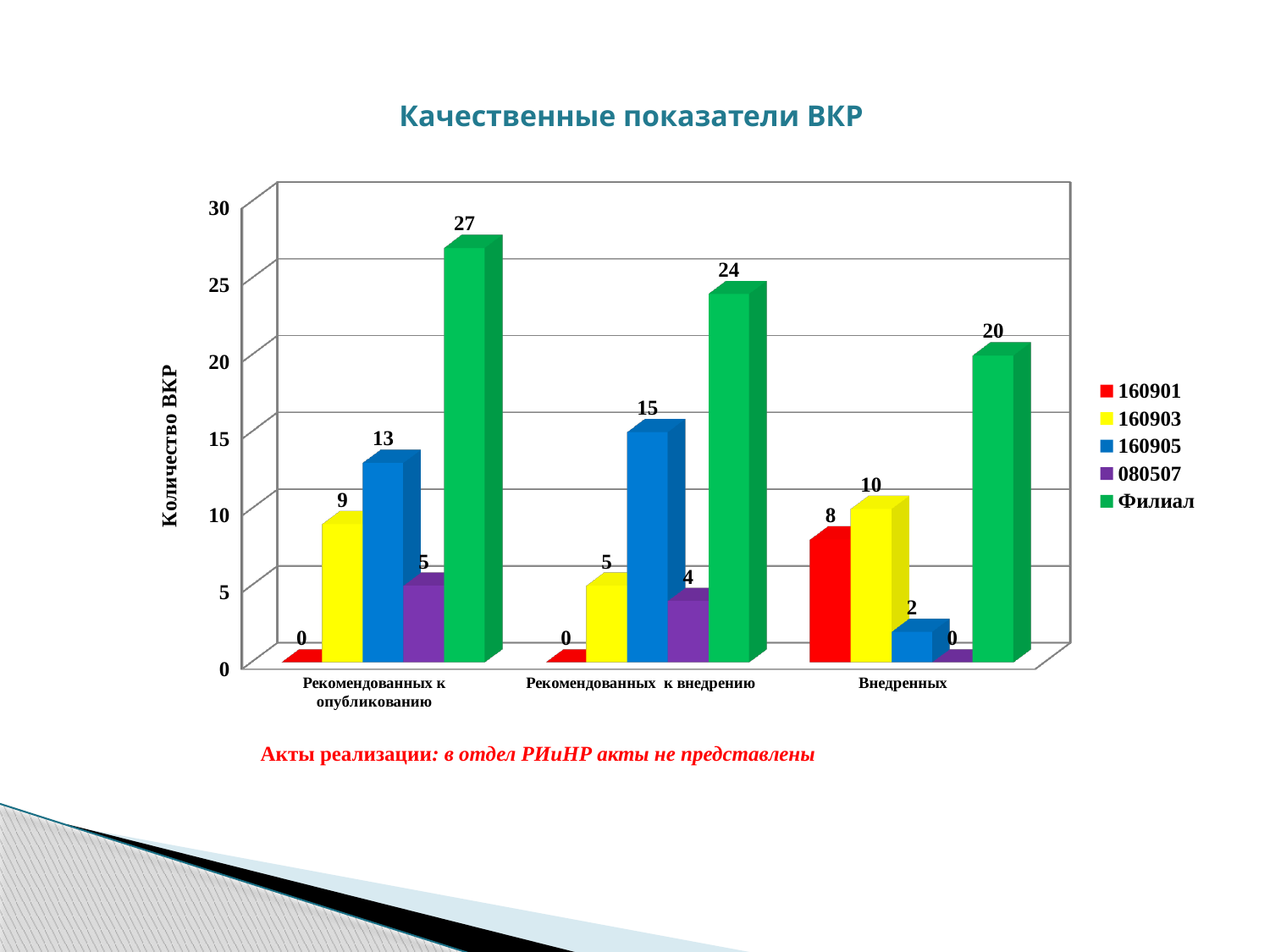
Which is larger in the Внедренных category: 160903 or 160905? 160903 What is the title of the y axis? Количество ВКР How many categories are shown on the x axis? 3 Which series has the lowest value in the Рекомендованных к опубликованию category? 160901 What is the value for Филиал in the Рекомендованных к опубликованию category? 27 How many series does the legend list? 5 What is the value for 080507 in the Рекомендованных к внедрению category? 4 What kind of chart is shown on the slide? Bar chart What is the value for 160901 in the Внедренных category? 8 Which series has the highest value in the Внедренных category? Филиал What is the difference between the Филиал values for Рекомендованных к опубликованию and Рекомендованных к внедрению? 3 What is the value for 160905 in the Рекомендованных к внедрению category? 15